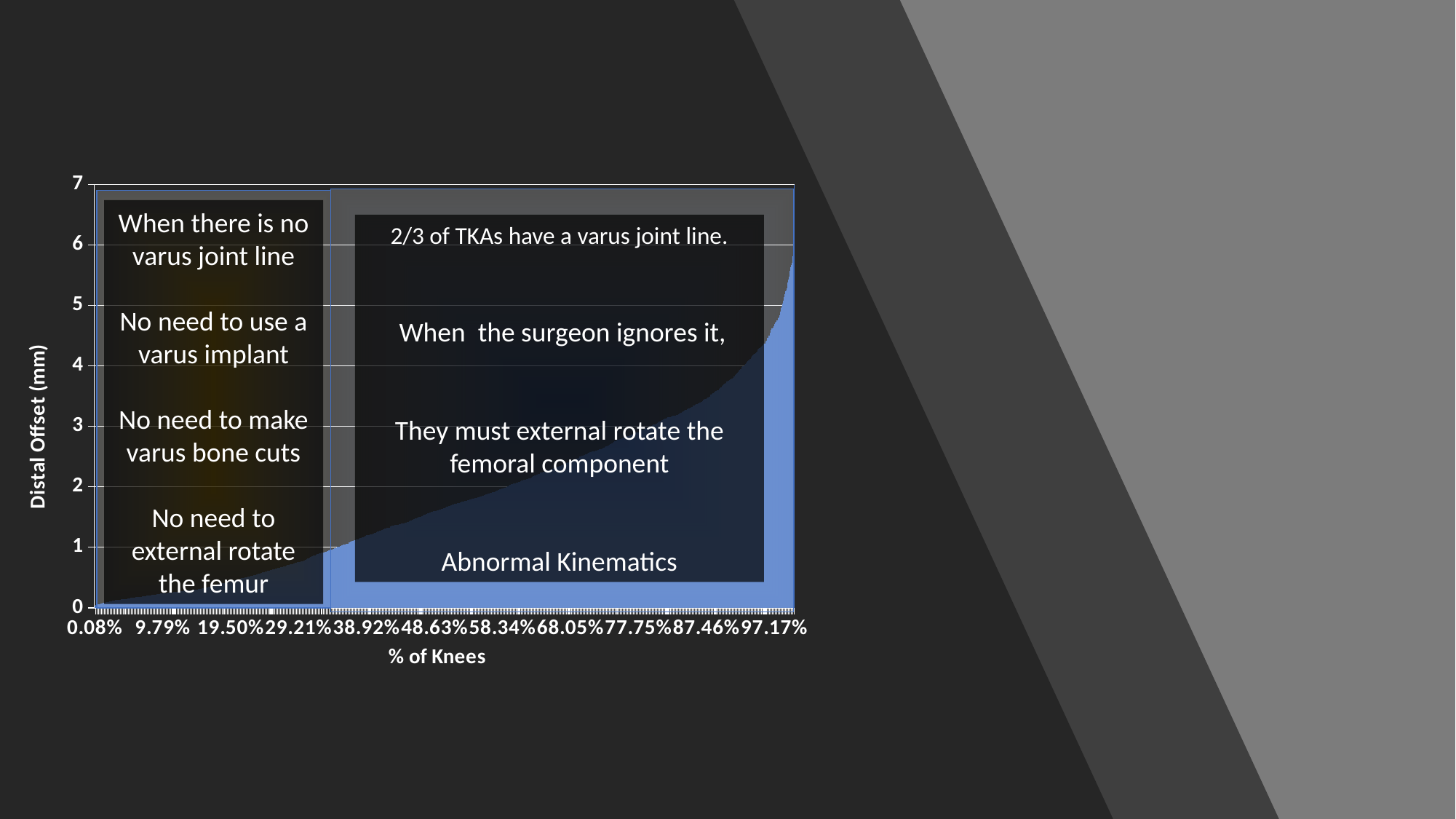
What is the title of the y axis of the chart? Distal Offset (mm) Is the distal offset at 48.63% of knees greater or less than 2? less Is the distal offset at 48.63% of knees greater or less than 1? greater Is the distal offset at 77.75% of knees greater or less than 2? greater What kind of chart is shown on the slide? area chart How many tick labels are shown on the x axis of the chart? 11 Do the plotted values rise or fall as you move from left to right along the x axis? rise What is the highest value shown on the y axis of the chart? 7 What is the title of the x axis of the chart? % of Knees